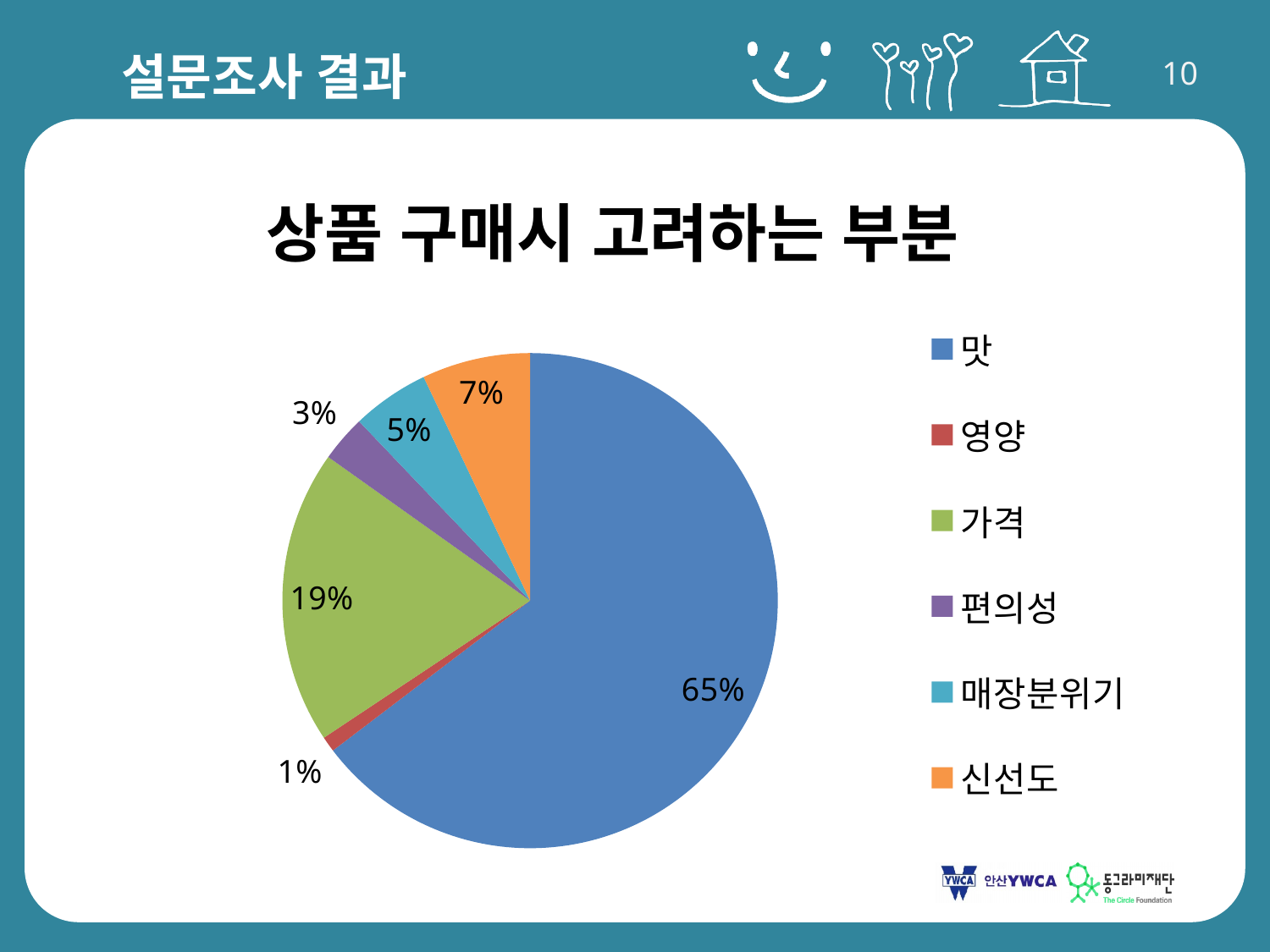
What percentage of the pie is 가격? 19% Which is larger, the share for 편의성 or the share for 매장분위기? 매장분위기 Which category has the smallest share of the pie? 영양 What kind of chart is shown on the slide? pie chart What percentage of the pie is 맛? 65% Which category has the largest share of the pie? 맛 How many categories does the legend list? 6 What percentage of the pie is 매장분위기? 5% What percentage of the pie is 영양? 1% What percentage of the pie is 신선도? 7% What is the title of the chart? 상품 구매시 고려하는 부분 What is the difference in percentage points between 맛 and 가격? 46